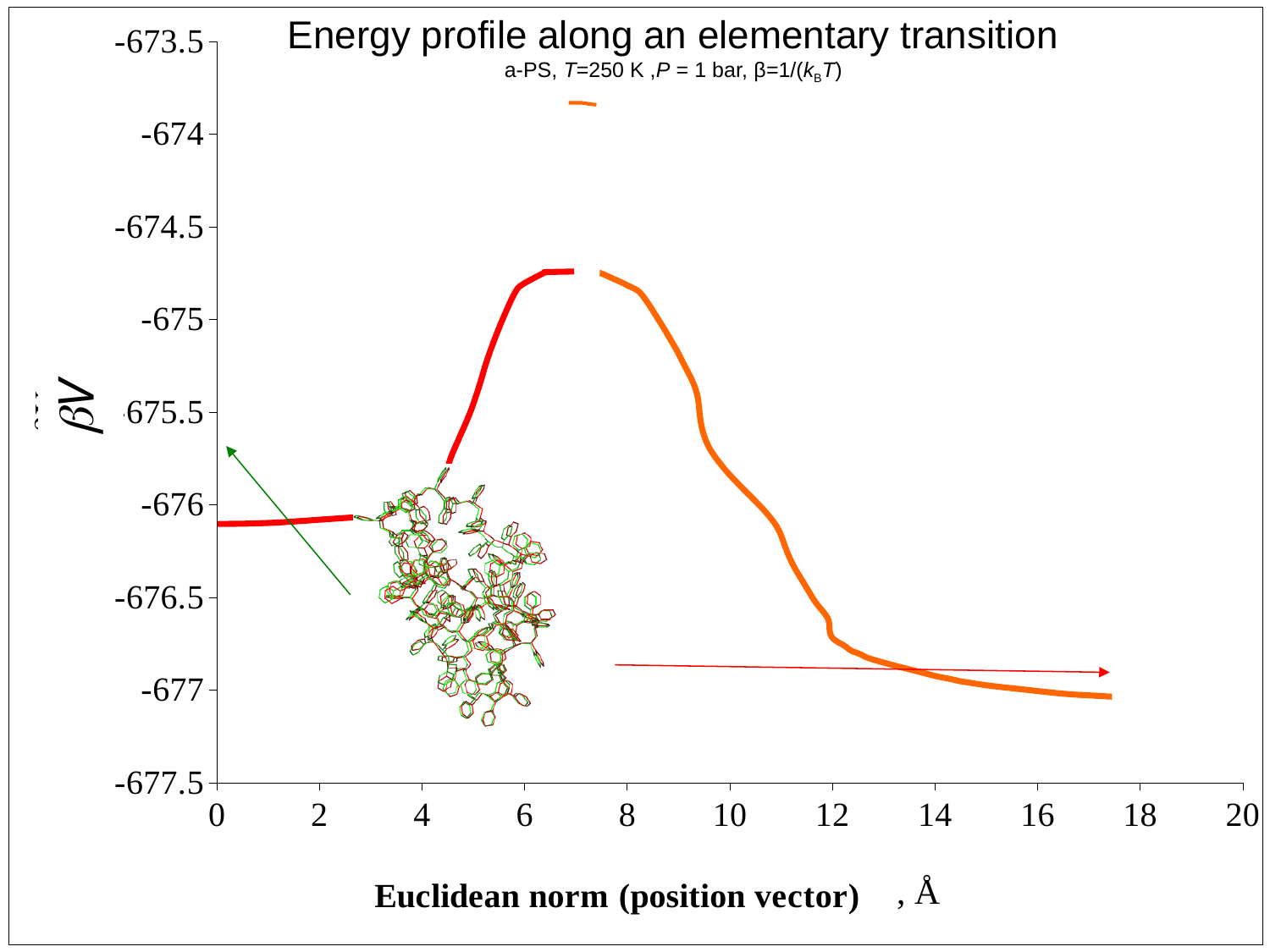
Is the value of the orange curve at x = 14 greater or less than -677? greater Is the value of the orange curve at x = 9 greater or less than -675? less Does the red curve rise or fall as x increases from 0 to 7? rise Is the value of the red curve at x = 6 greater or less than -675? greater What kind of chart is shown on the slide? line chart Does the orange curve rise or fall as x increases from 8 to 17.5? fall What is the label of the x axis? Euclidean norm (position vector), Å What is the highest value shown on the x axis? 20 What is the title of the chart? Energy profile along an elementary transition